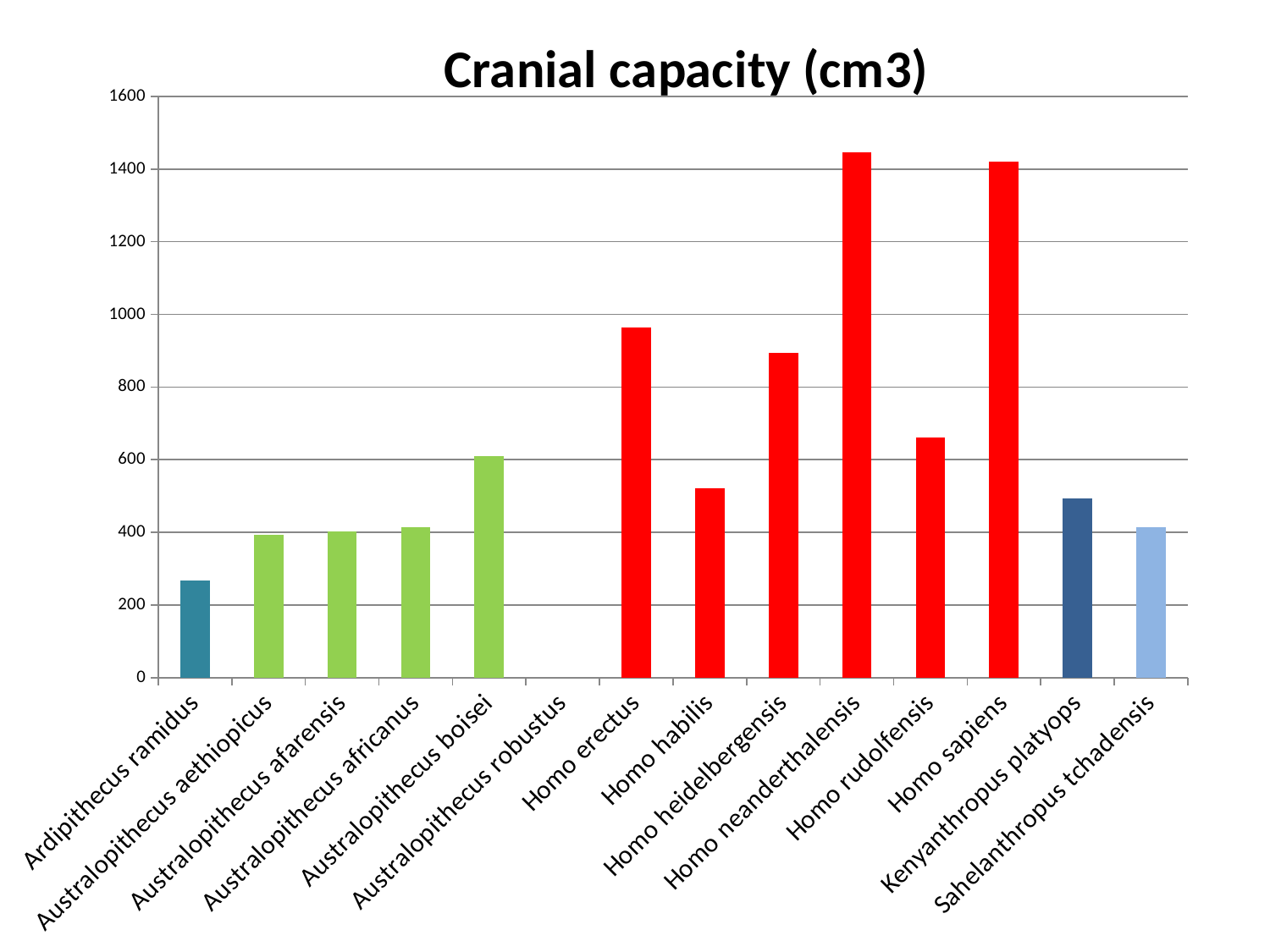
Is the value for Homo heidelbergensis greater or less than 800? greater What is the title of the chart? Cranial capacity (cm3) Is the value for Homo erectus greater or less than 800? greater Is the value for Homo habilis greater or less than 600? less Which is larger, the value for Homo erectus or the value for Homo heidelbergensis? Homo erectus What kind of chart is shown on the slide? bar chart Which is larger, the value for Homo habilis or the value for Homo rudolfensis? Homo rudolfensis How many categories are labelled on the x axis? 14 Which category has no bar plotted? Australopithecus robustus